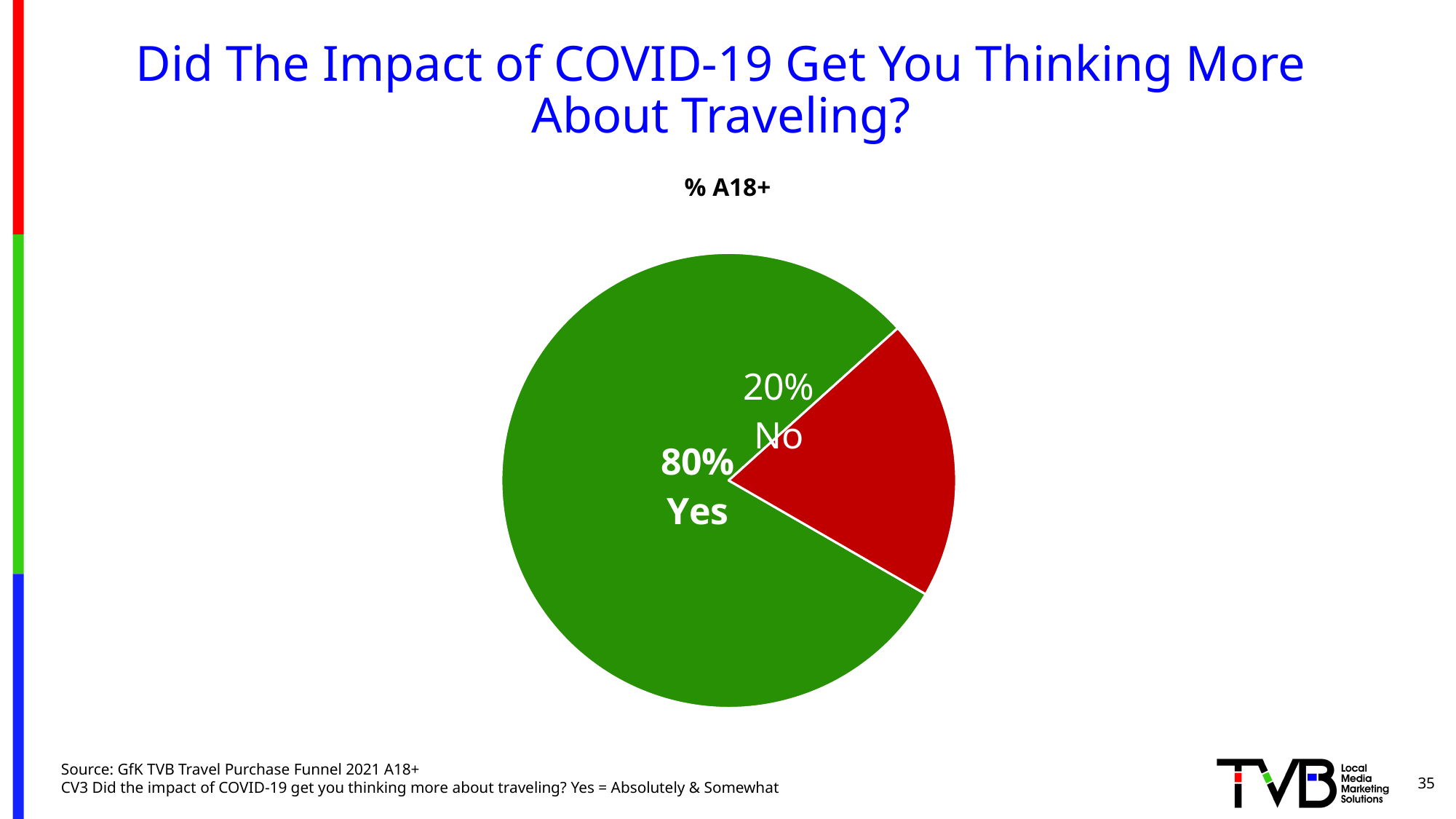
What percentage of respondents answered No? 20% Which response has the largest share of the pie? Yes Which slice is larger, Yes or No? Yes What is the difference in percentage points between the Yes and No slices? 60 What is the title shown directly above the pie chart? % A18+ How many slices does the pie chart have? 2 What colour is the Yes slice? green What kind of chart is shown on the slide? pie chart What share of the pie does the No slice represent? 20% Which response has the smallest share of the pie? No What percentage of respondents answered Yes? 80%